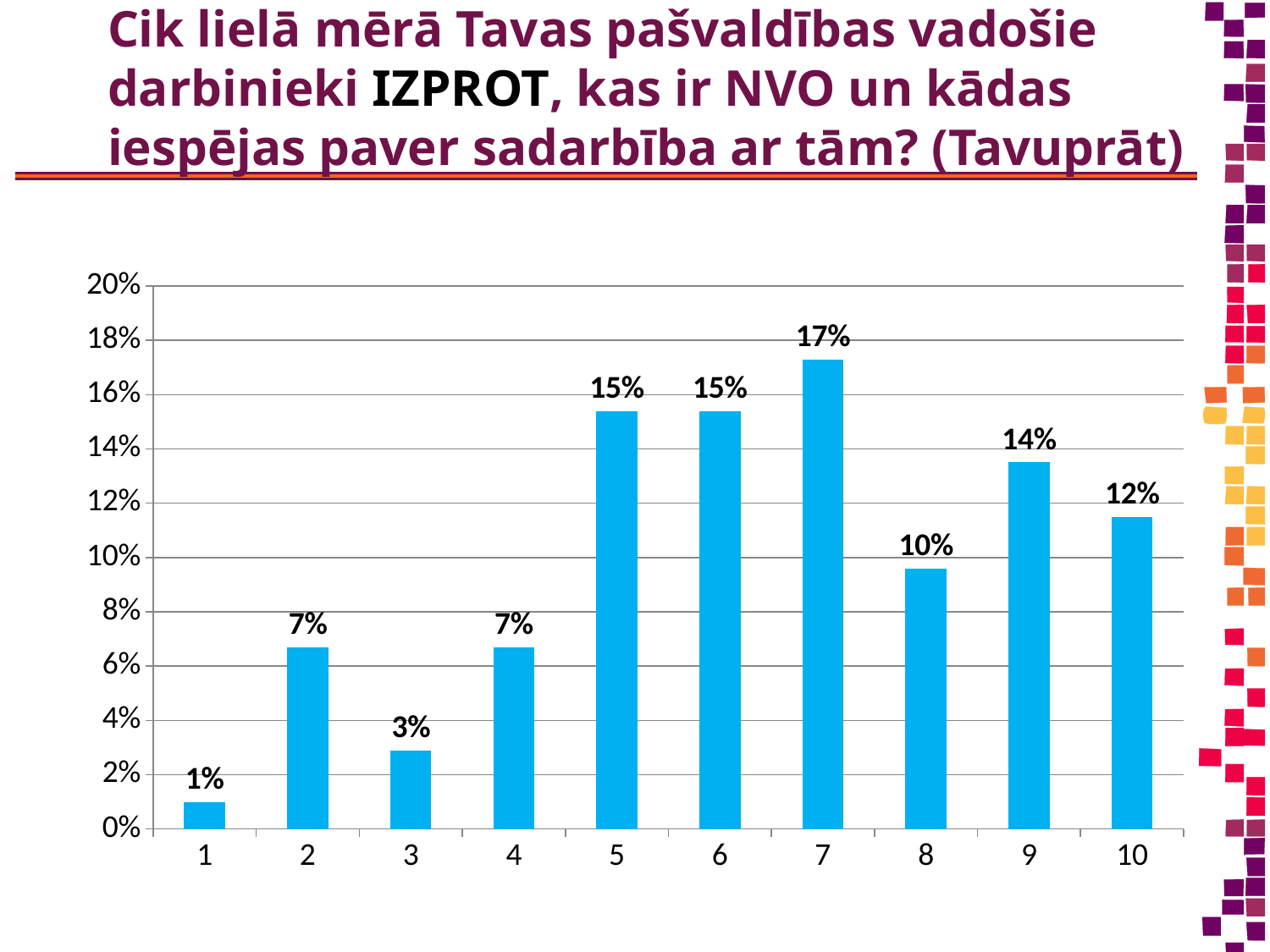
What is the value for category 7? 17% Which category has the lowest value? 1 What colour are the bars in the chart? blue What kind of chart is shown on the slide? bar chart What is the value for category 9? 14% Which category has the highest value? 7 What is the difference between the values for category 7 and category 8? 7% What is the difference between the values for category 2 and category 3? 4% How many categories are shown on the x axis? 10 What is the value for category 1? 1% Is the value for category 10 greater or less than 10%? greater